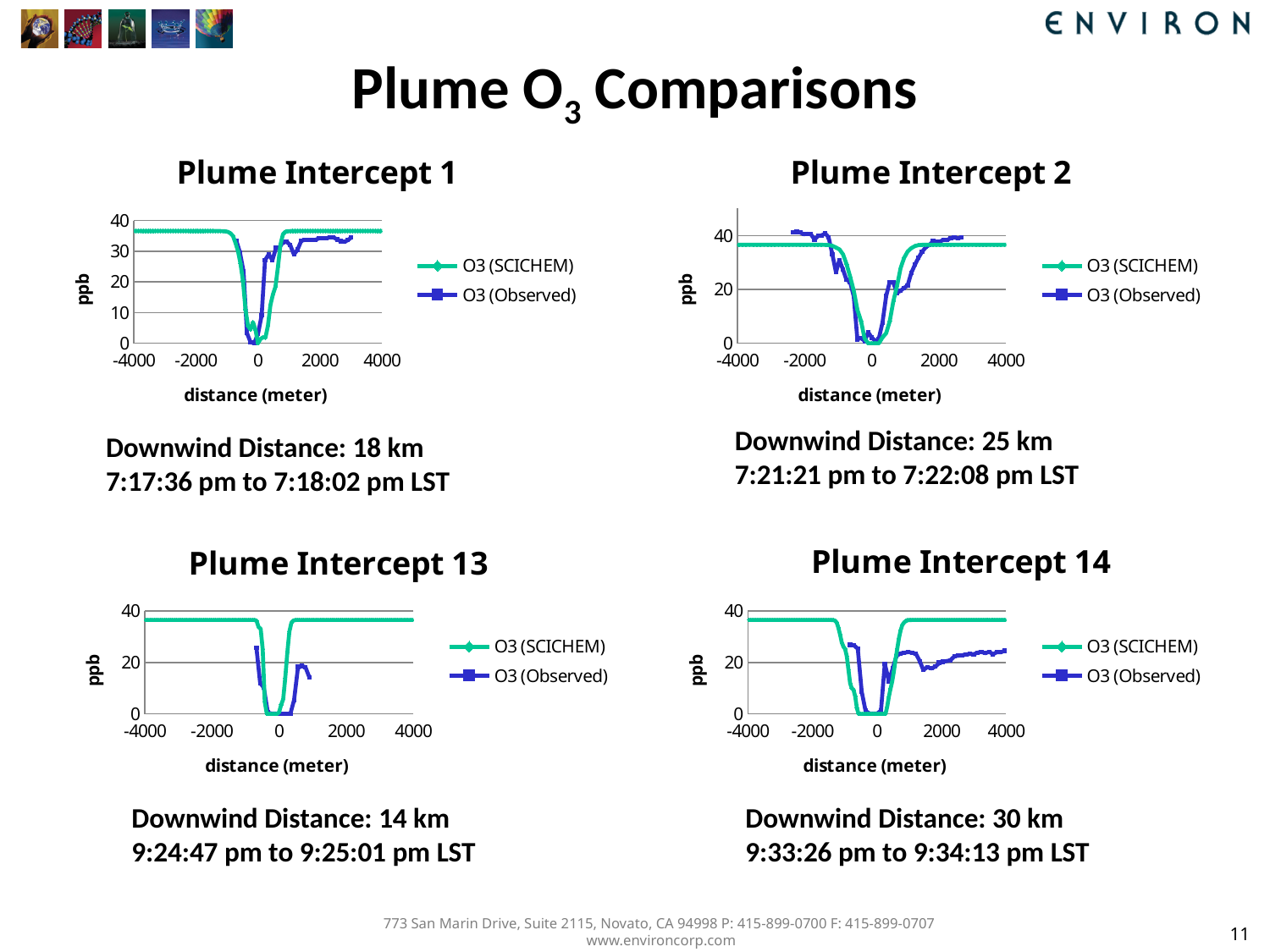
In 'Plume Intercept 13', is the O3 (SCICHEM) value at distance 4000 greater or less than 20? greater In 'Plume Intercept 2', is the O3 (SCICHEM) value at distance 0 greater or less than 20? less What are the two series named in the legend of 'Plume Intercept 13'? O3 (SCICHEM) and O3 (Observed) In 'Plume Intercept 2', does the O3 (SCICHEM) line rise or fall as distance goes from 0 to 1000? rise In 'Plume Intercept 1', does the O3 (SCICHEM) line rise or fall as distance goes from -1000 to 0? fall In 'Plume Intercept 1', is the O3 (SCICHEM) value at distance -4000 greater or less than 30? greater How many series does the legend of 'Plume Intercept 2' list? 2 What kind of chart is 'Plume Intercept 1'? line chart What is the x-axis label of the 'Plume Intercept 14' chart? distance (meter) In 'Plume Intercept 2', at distance -2000, which series has the higher value, O3 (SCICHEM) or O3 (Observed)? O3 (Observed)